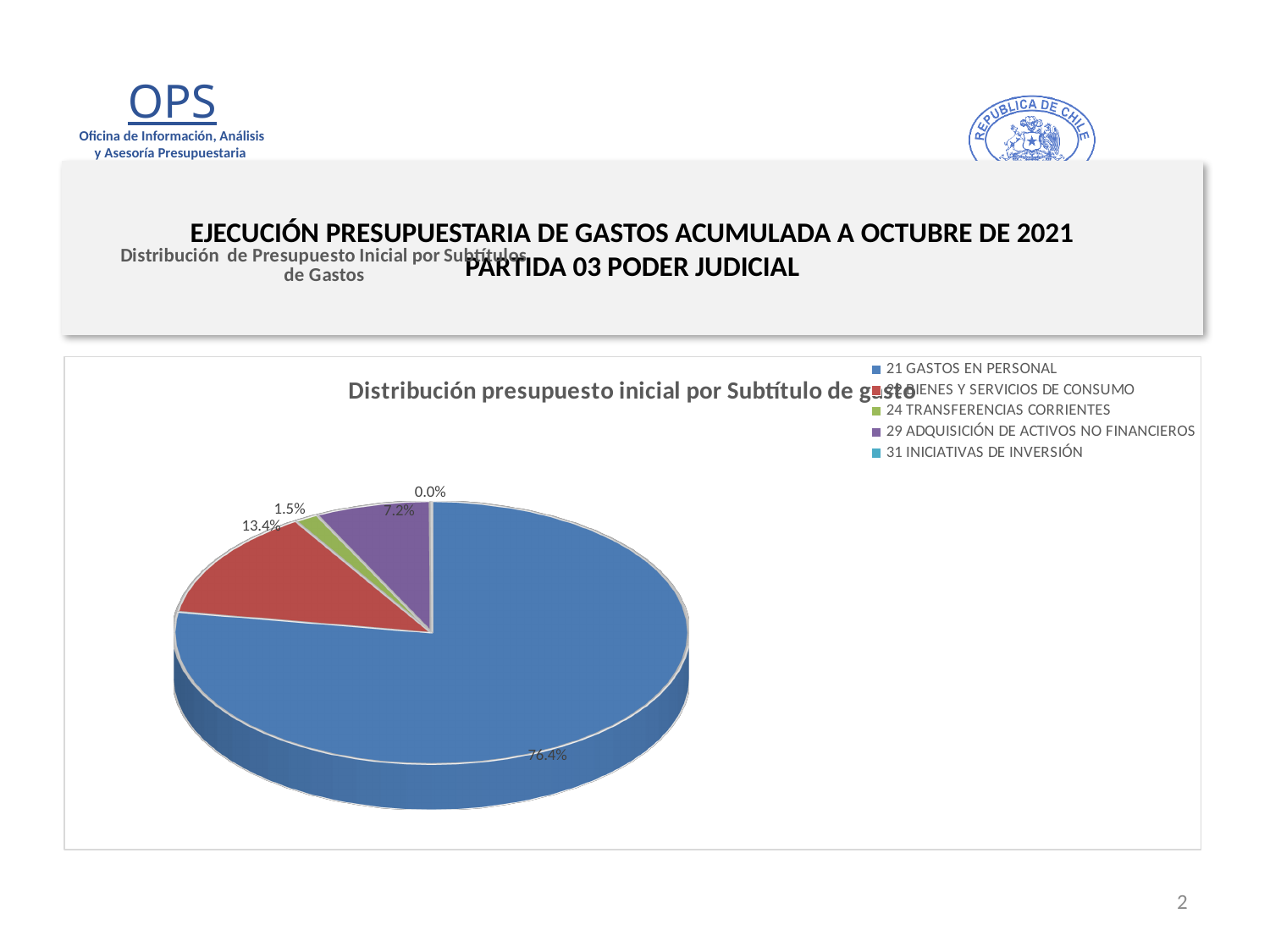
What share of the pie does 21 GASTOS EN PERSONAL represent? 76.4% What percentage is shown for 24 TRANSFERENCIAS CORRIENTES? 1.5% What percentage is shown for 29 ADQUISICIÓN DE ACTIVOS NO FINANCIEROS? 7.2% Which subtítulo has the smallest share of the pie? 31 INICIATIVAS DE INVERSIÓN How many categories does the legend list? 5 What percentage is shown for the BIENES Y SERVICIOS DE CONSUMO slice? 13.4% Which subtítulo has the largest share of the pie? 21 GASTOS EN PERSONAL What percentage is shown for 31 INICIATIVAS DE INVERSIÓN? 0.0% What is the difference in percentage points between the 21 GASTOS EN PERSONAL slice and the BIENES Y SERVICIOS DE CONSUMO slice? 63.0 percentage points What is the title of the chart? Distribución presupuesto inicial por Subtítulo de gasto What kind of chart is shown on the slide? Pie chart Which is larger: the share for 29 ADQUISICIÓN DE ACTIVOS NO FINANCIEROS or for 24 TRANSFERENCIAS CORRIENTES? 29 ADQUISICIÓN DE ACTIVOS NO FINANCIEROS